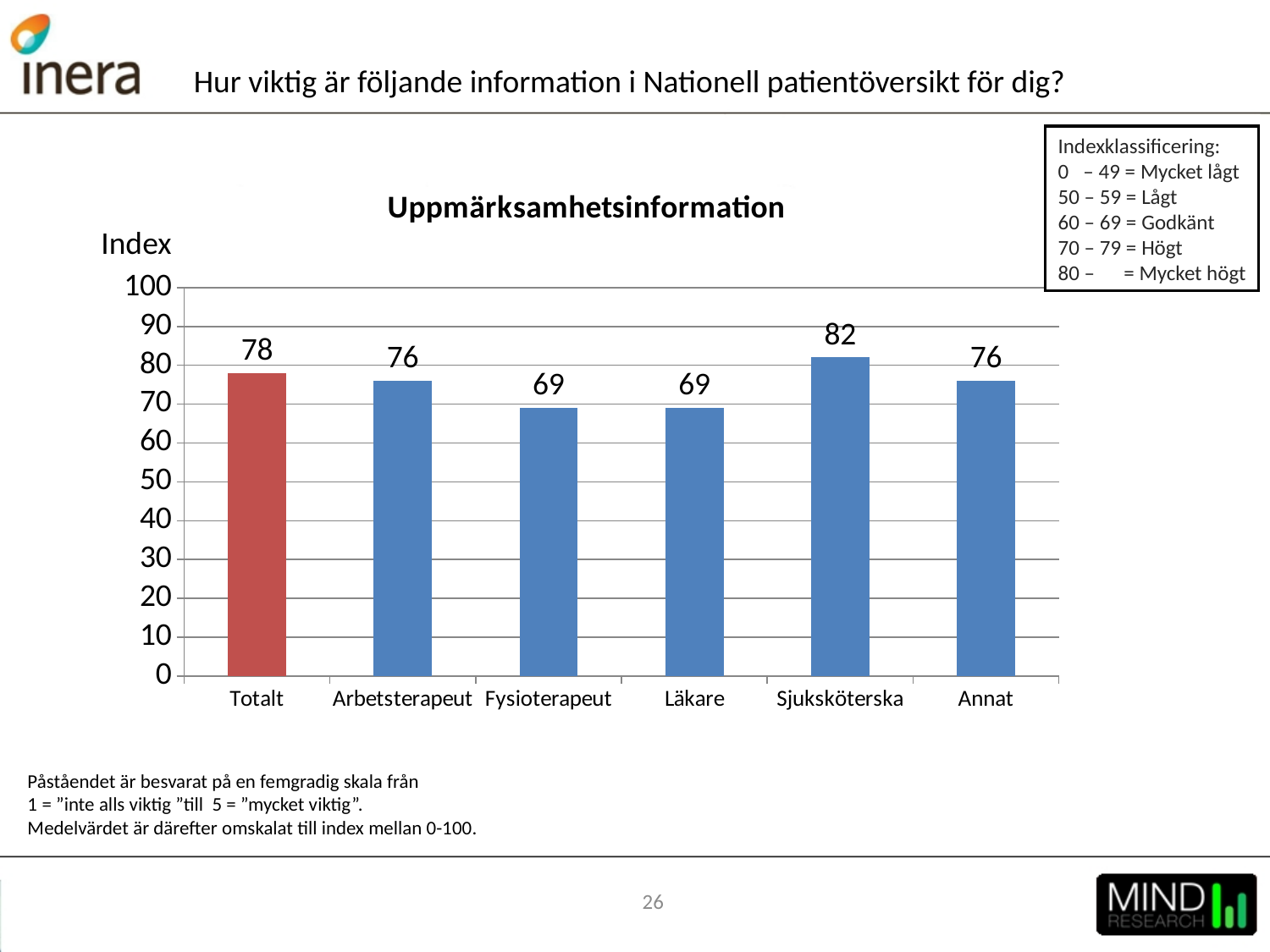
How many categories are shown on the x axis? 6 What kind of chart is shown on the slide? bar chart What is the difference between the index values for Sjuksköterska and Läkare? 13 What is the index value for Totalt? 78 What is the index value for Fysioterapeut? 69 What is the index value for Sjuksköterska? 82 Which bar is coloured red rather than blue? Totalt Which has a higher index value, Totalt or Arbetsterapeut? Totalt What is the difference between the index values for Totalt and Annat? 2 What is the title of the chart? Uppmärksamhetsinformation Is the value for Annat greater or less than 70? greater Which category has the highest index value? Sjuksköterska